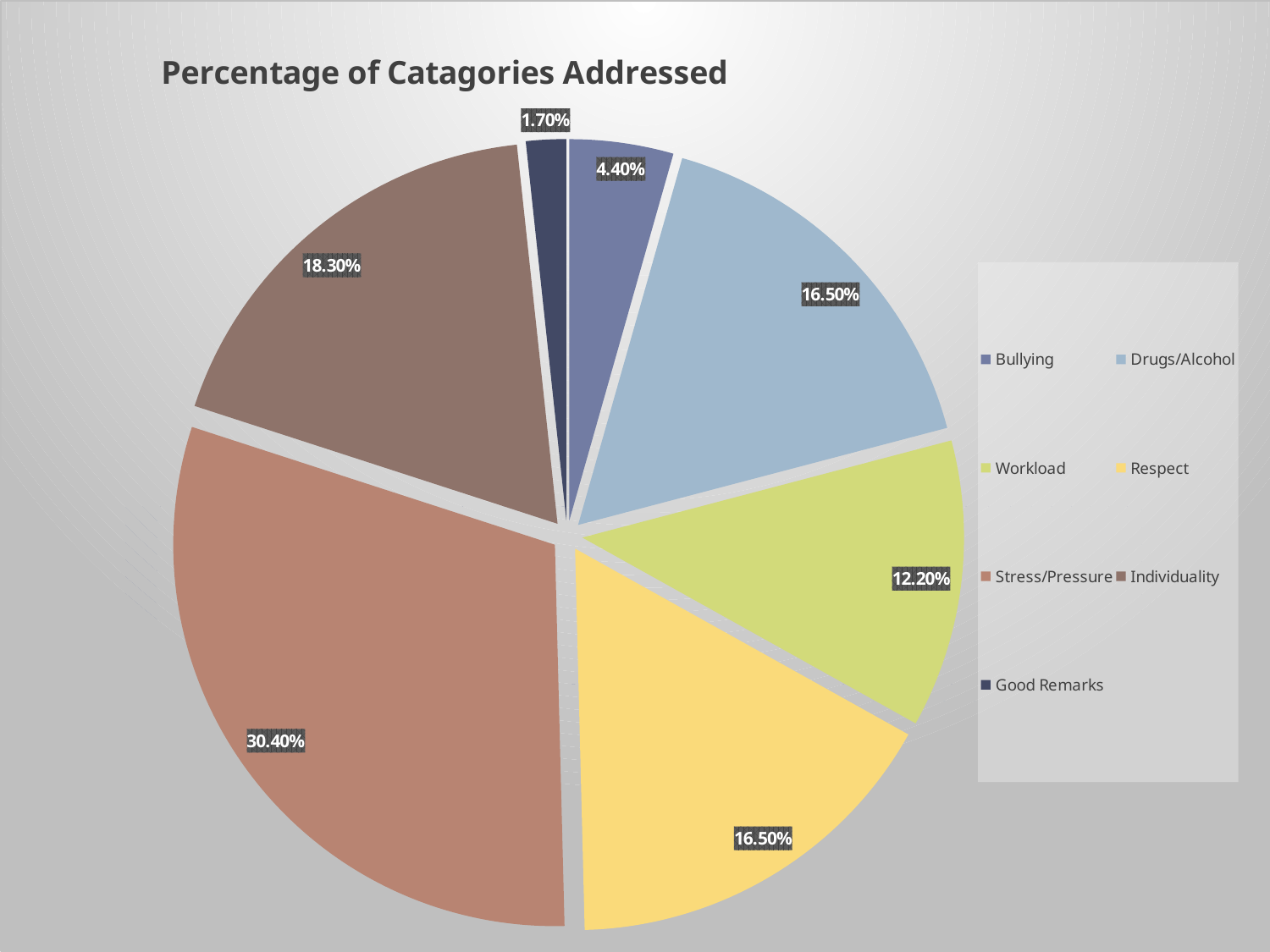
What is the title of the chart? Percentage of Catagories Addressed Which category has the smallest share of the pie? Good Remarks Which is larger, the Bullying slice or the Workload slice? Workload What type of chart is shown on the slide? Pie chart What is the difference between the Bullying and Good Remarks percentages? 2.70% What percentage does the Individuality slice represent? 18.30% How many categories are shown in the pie chart? 7 What is the difference between the Stress/Pressure and Individuality percentages? 12.10% What percentage does the Stress/Pressure slice represent? 30.40% What percentage does the Good Remarks slice represent? 1.70% What percentage does the Workload slice represent? 12.20% Which category has the largest share of the pie? Stress/Pressure